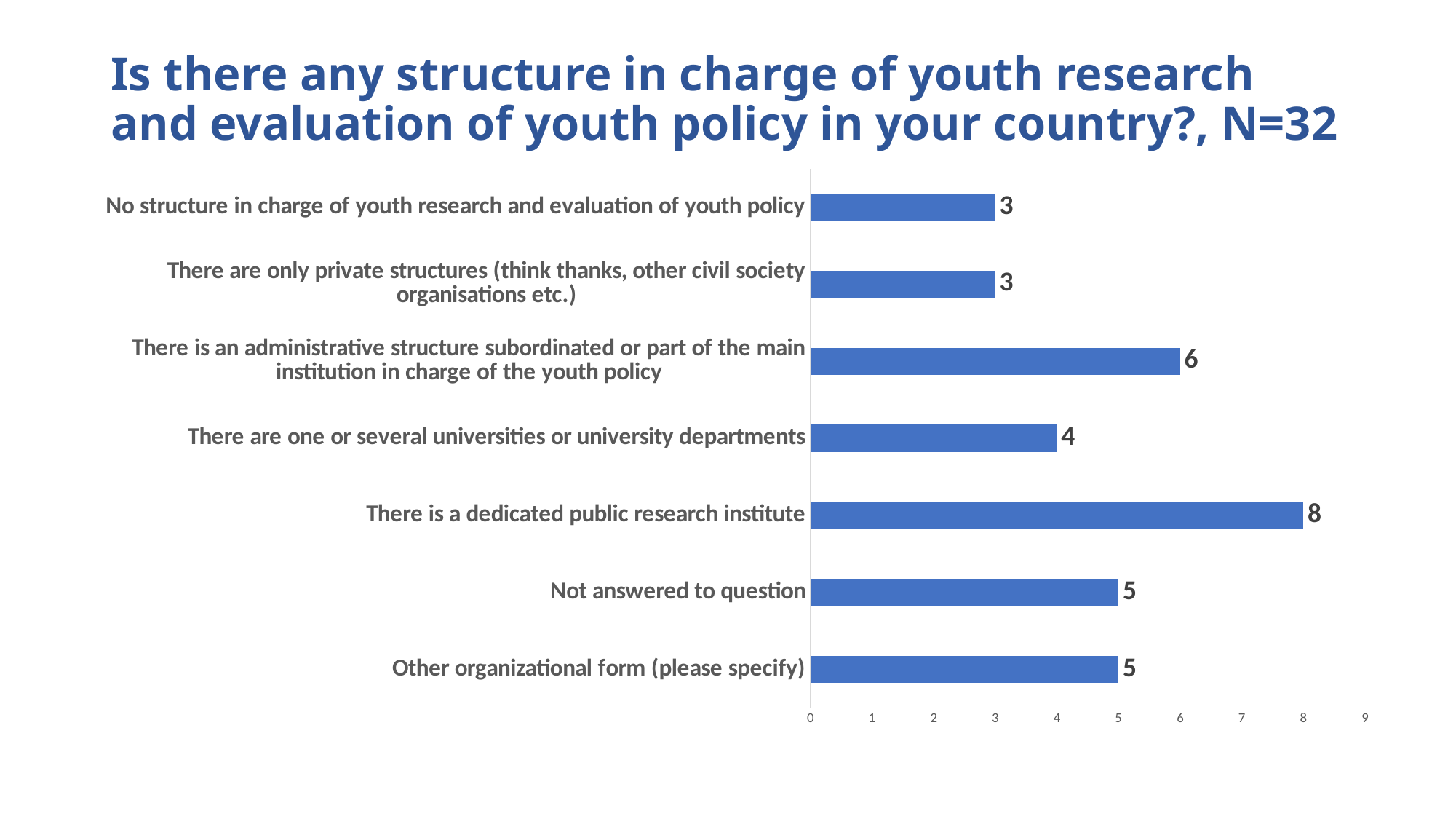
How many categories are shown in the chart? 7 What is the value for 'Not answered to question'? 5 What is the value for 'There is an administrative structure subordinated or part of the main institution in charge of the youth policy'? 6 Which is larger: the value for 'There is an administrative structure subordinated or part of the main institution in charge of the youth policy' or the value for 'Other organizational form (please specify)'? There is an administrative structure subordinated or part of the main institution in charge of the youth policy What is the difference between the value for 'Not answered to question' and the value for 'No structure in charge of youth research and evaluation of youth policy'? 2 What is the difference between the value for 'There is a dedicated public research institute' and the value for 'There are one or several universities or university departments'? 4 What is the value for 'There are one or several universities or university departments'? 4 What kind of chart is shown on the slide? Bar chart Which category has the highest value? There is a dedicated public research institute What is the value for 'There is a dedicated public research institute'? 8 Is the value for 'There is a dedicated public research institute' greater or less than 7? greater What is the N stated in the chart title? 32